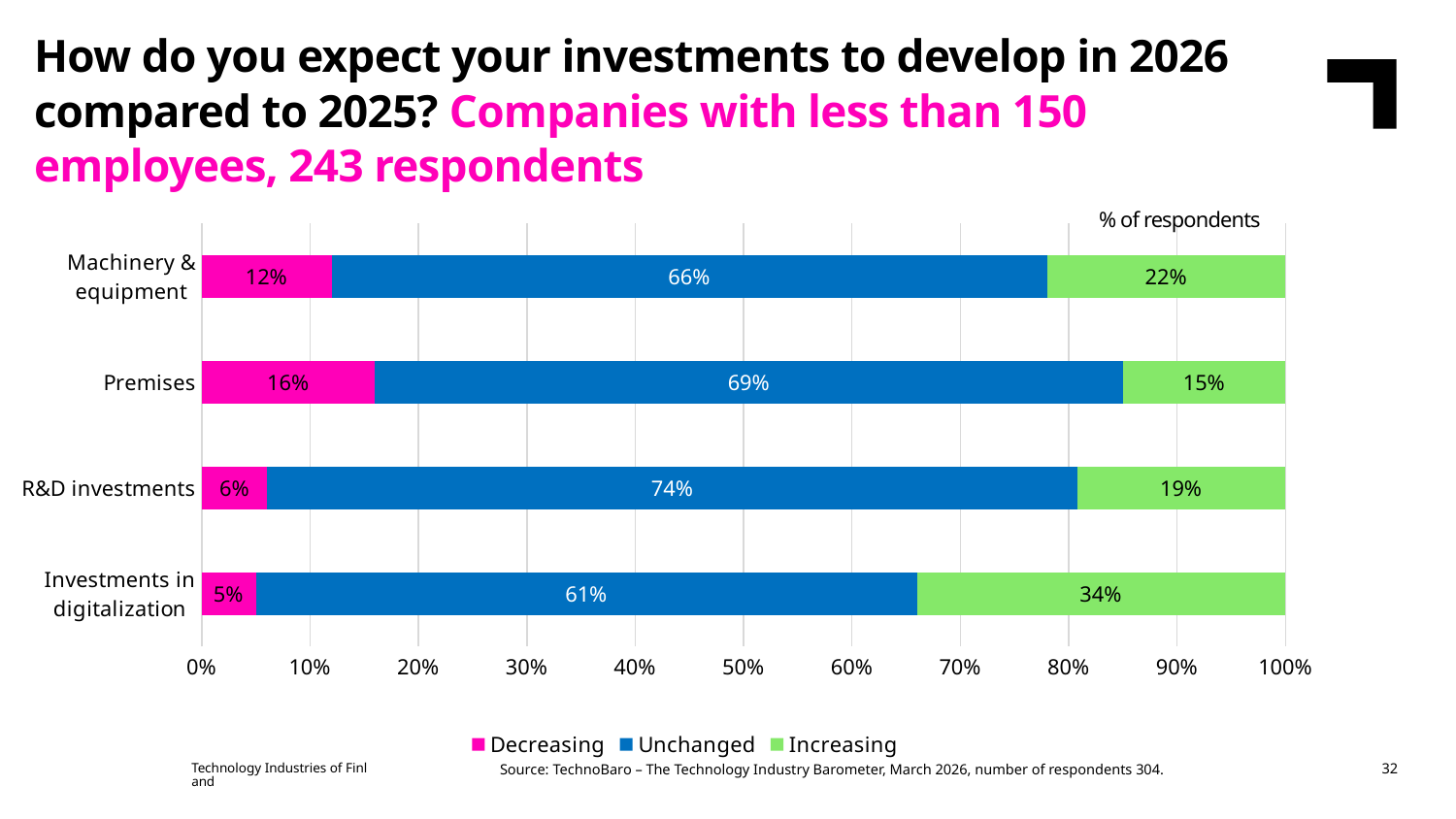
How many series does the legend list? 3 What is the total of the stacked bar for R&D investments? 99% How many categories are shown on the chart? 4 What kind of chart is shown on the slide? Stacked bar chart What is the Increasing value for Investments in digitalization? 34% What is the Decreasing value for Premises? 16% Which category has the highest Increasing share? Investments in digitalization What is the difference between the Increasing values for Investments in digitalization and Premises? 19 percentage points Which category has the lowest Decreasing share? Investments in digitalization Is the Decreasing value larger for Premises or for R&D investments? Premises Which category has the highest Unchanged share? R&D investments What percentage of respondents expect Machinery & equipment investments to be unchanged? 66%